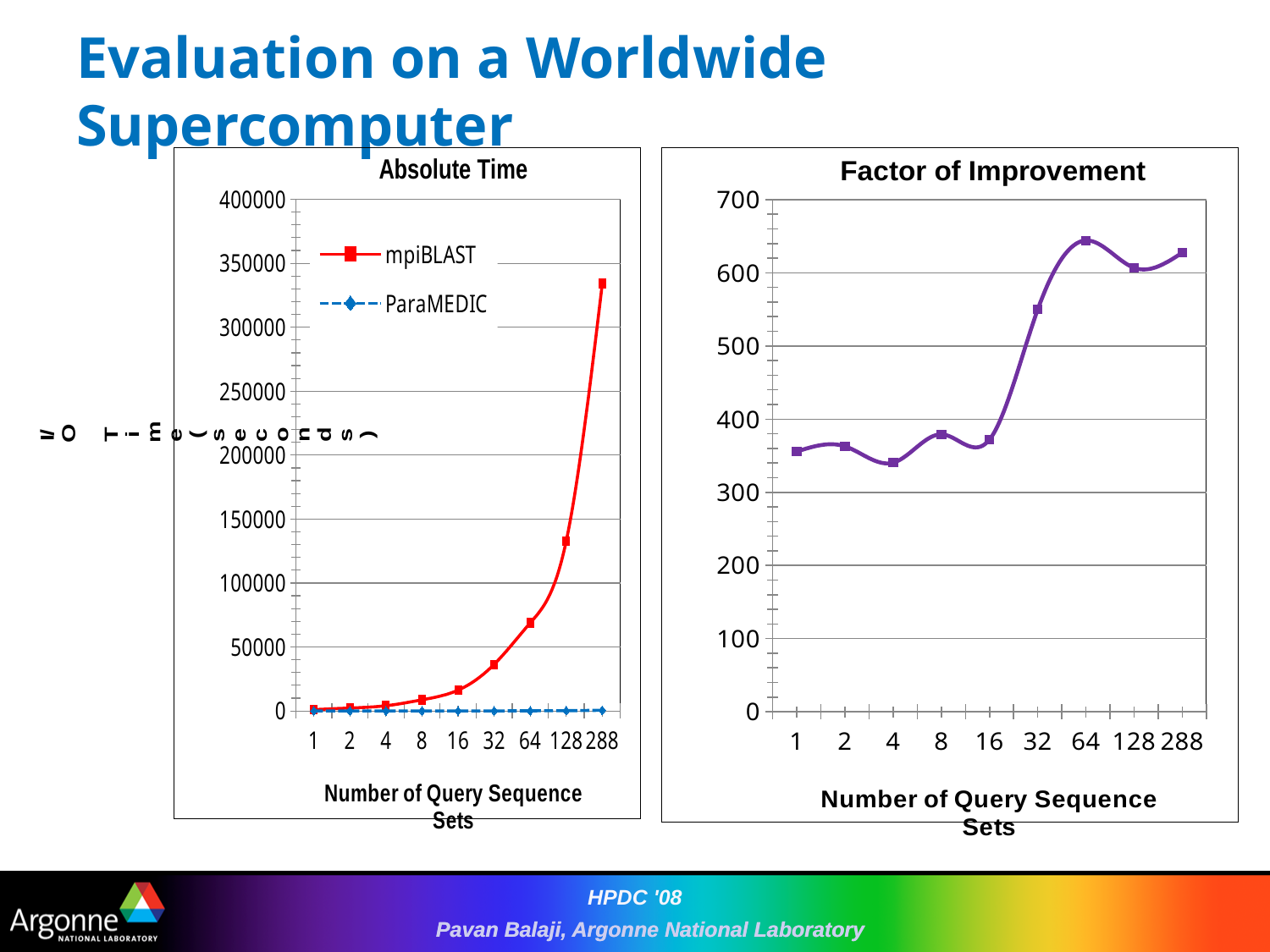
How many points along the x axis does the Factor of Improvement chart have? 9 In the Factor of Improvement chart, is the value at 64 query sequence sets greater or less than 600? greater In the Factor of Improvement chart, which has the larger value, 16 or 32 query sequence sets? 32 In the Factor of Improvement chart, at which number of query sequence sets is the factor of improvement highest? 64 How many series does the legend of the Absolute Time chart list? 2 In the Factor of Improvement chart, is the value at 4 query sequence sets greater or less than 400? less In the Absolute Time chart, is the mpiBLAST value at 128 query sequence sets greater or less than 100000? greater What kind of chart is the Absolute Time chart? line chart In the Absolute Time chart, which series is shown in red? mpiBLAST In the Absolute Time chart, which series has the larger value at 288 query sequence sets, mpiBLAST or ParaMEDIC? mpiBLAST In the Absolute Time chart, do the mpiBLAST values rise or fall as the number of query sequence sets increases? rise